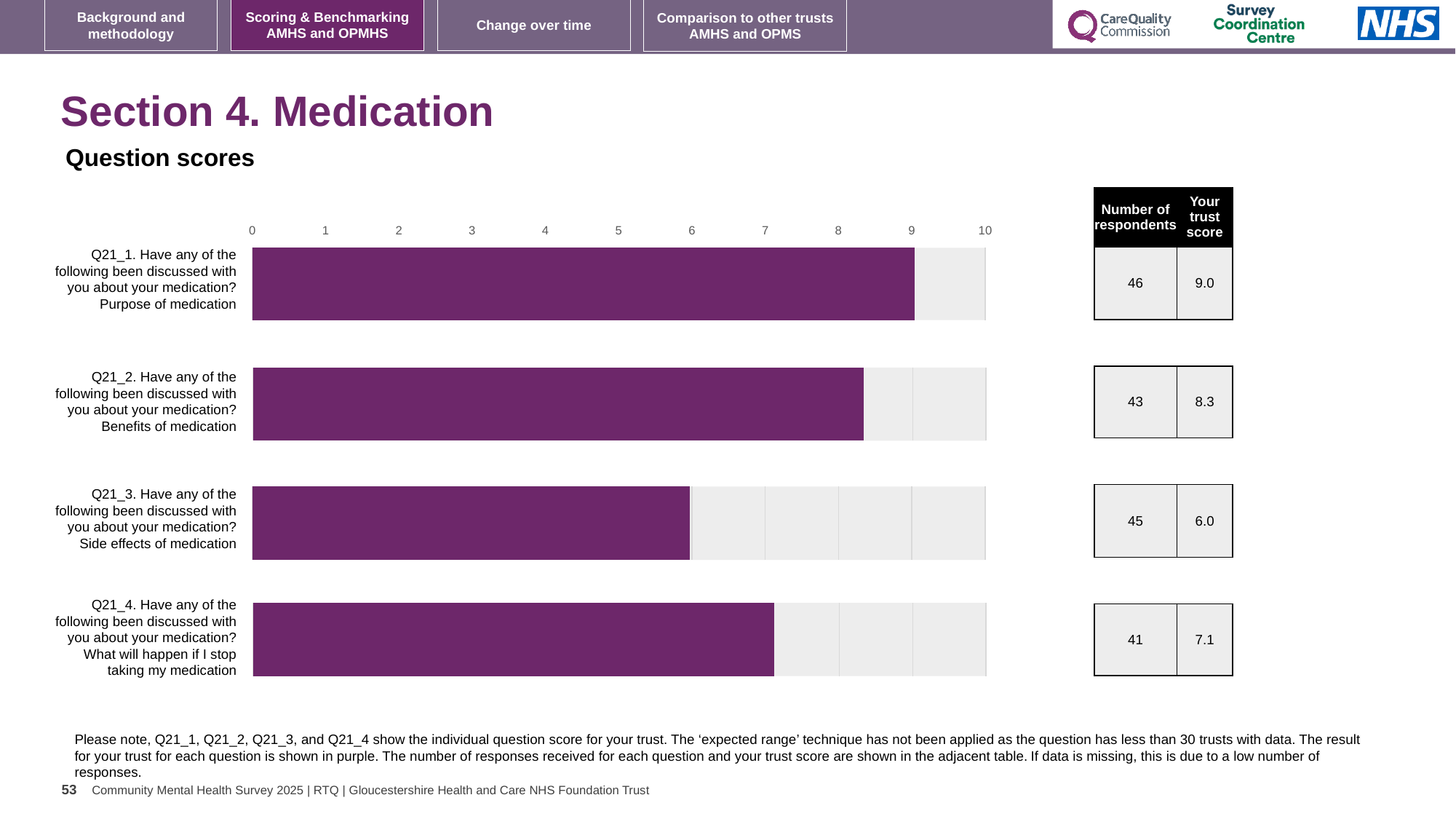
What is the trust score for Q21_1 (Purpose of medication)? 9.0 What is the difference between the trust scores for Q21_2 (Benefits of medication) and Q21_4 (What will happen if I stop taking my medication)? 1.2 What is the trust score for Q21_3 (Side effects of medication)? 6.0 What colour are the bars showing the trust's results? Purple How many respondents answered Q21_4 (What will happen if I stop taking my medication)? 41 What kind of chart is shown on the slide? Bar chart Is the trust score for Q21_3 (Side effects of medication) greater or less than 7? less Which question has the highest trust score? Q21_1. Purpose of medication How many questions are plotted in the chart? 4 Which has the larger trust score, Q21_2 (Benefits of medication) or Q21_4 (What will happen if I stop taking my medication)? Q21_2. Benefits of medication What is the maximum value shown on the chart's axis? 10 Which question has the lowest trust score? Q21_3. Side effects of medication